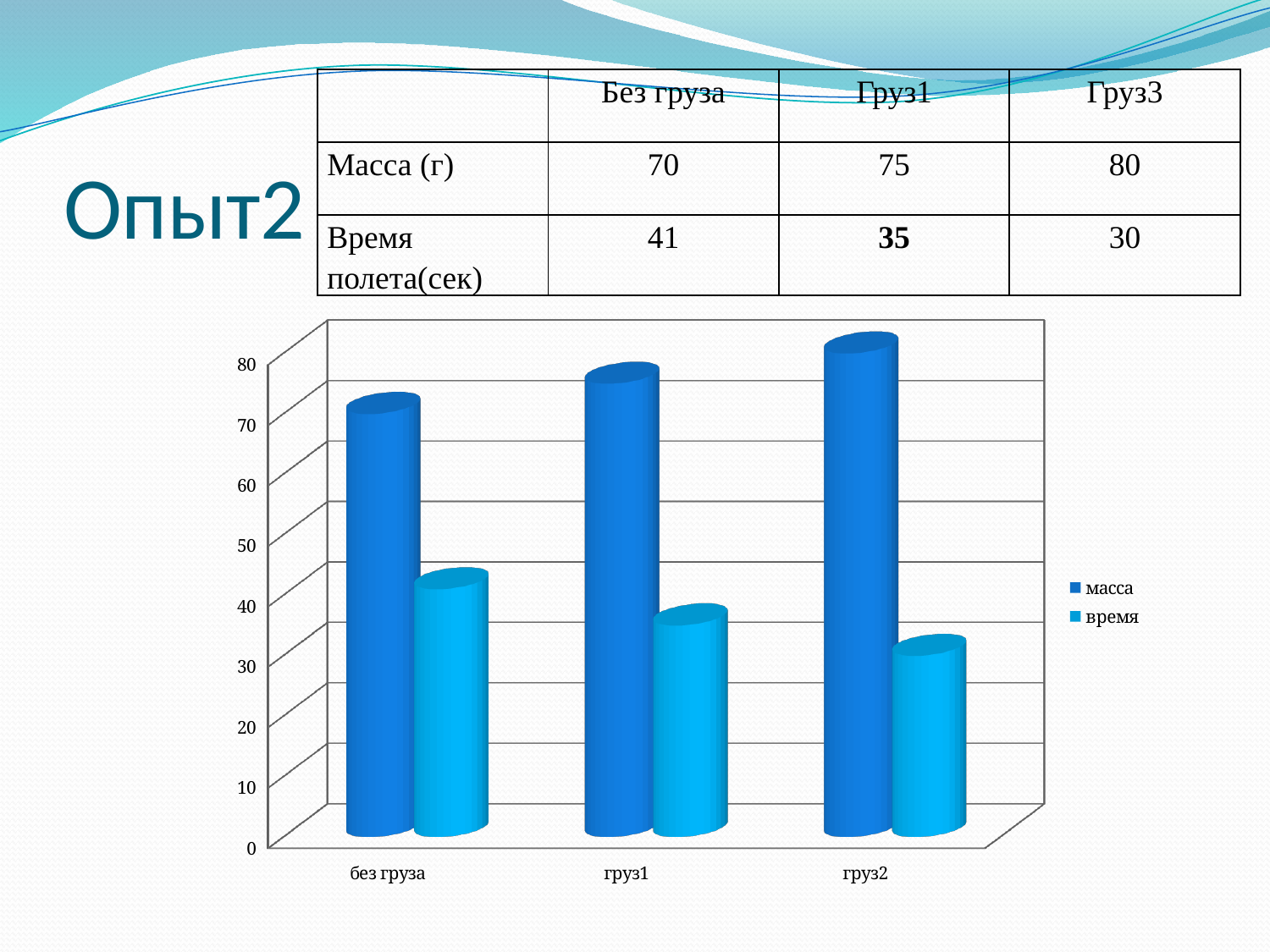
What is the value of масса for груз2 in the chart? 80 Do the масса values rise or fall from без груза to груз2 along the x axis? rise Is the value of время for груз1 greater or less than 30? greater How many series does the chart legend list? 2 How many categories are shown on the x axis of the chart? 3 What is the difference between the масса value for груз2 and the масса value for без груза? 10 What kind of chart is shown on the slide? bar chart What is the value of масса for без груза in the chart? 70 Which category has the highest масса value in the chart? груз2 For груз1, which is larger: масса or время? масса Which category has the lowest время value in the chart? груз2 What is the value of время for груз2 in the chart? 30